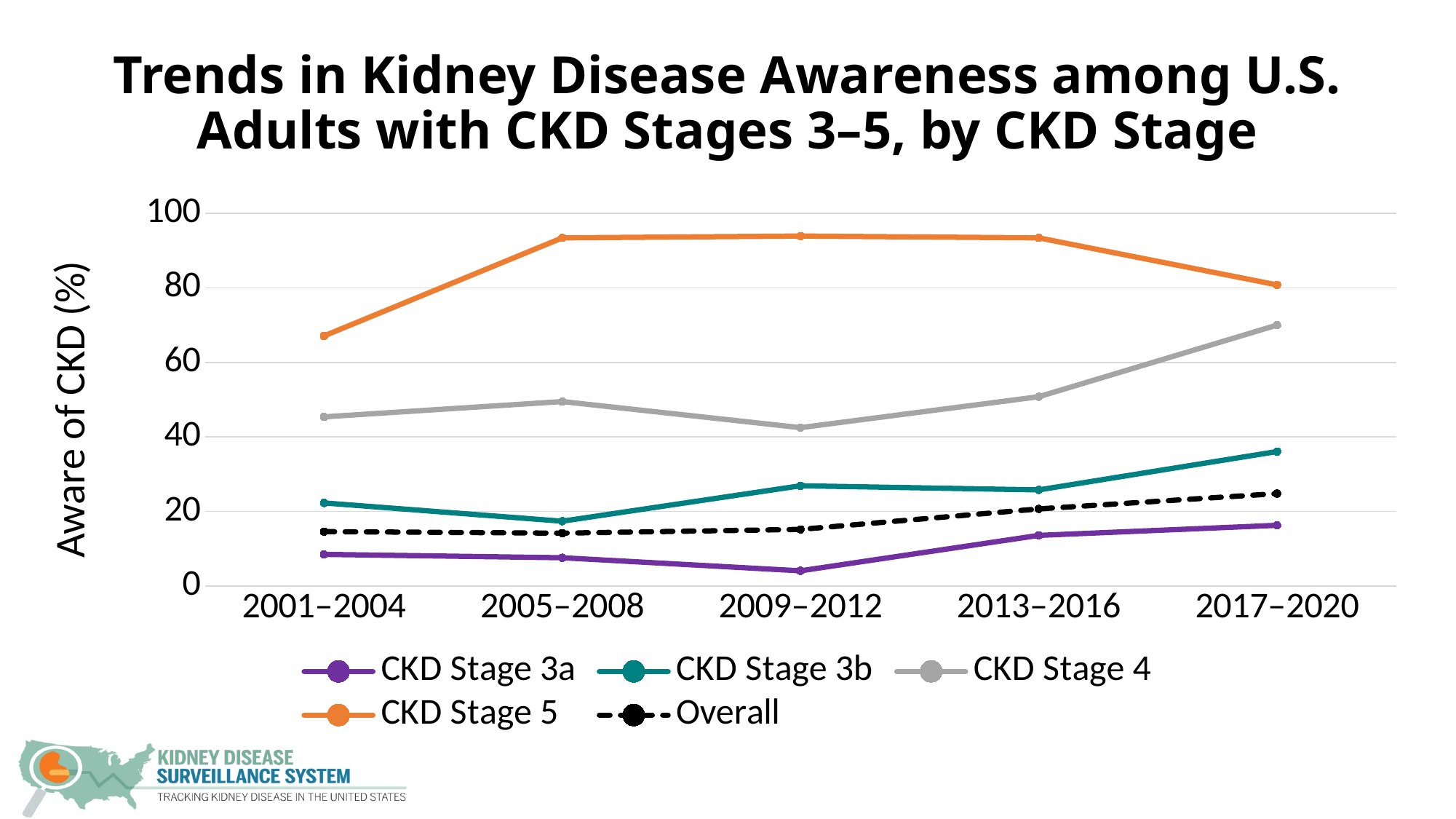
Which series has the lowest awareness in 2001–2004? CKD Stage 3a How many time periods are shown on the x axis? 5 In 2017–2020, which is larger: the value for CKD Stage 3b or the value for Overall? CKD Stage 3b Is the value for CKD Stage 5 in 2009–2012 greater or less than 80? greater How many series does the legend list? 5 What kind of chart is shown on the slide? line chart In which period is the value for CKD Stage 3a lowest? 2009–2012 Which series is drawn with a dashed line? Overall Is the value for CKD Stage 4 in 2017–2020 greater or less than 60? greater Does the value for CKD Stage 4 rise or fall from 2009–2012 to 2017–2020? rise Is the value for CKD Stage 3a in 2009–2012 greater or less than 20? less Which series has the highest awareness in 2017–2020? CKD Stage 5